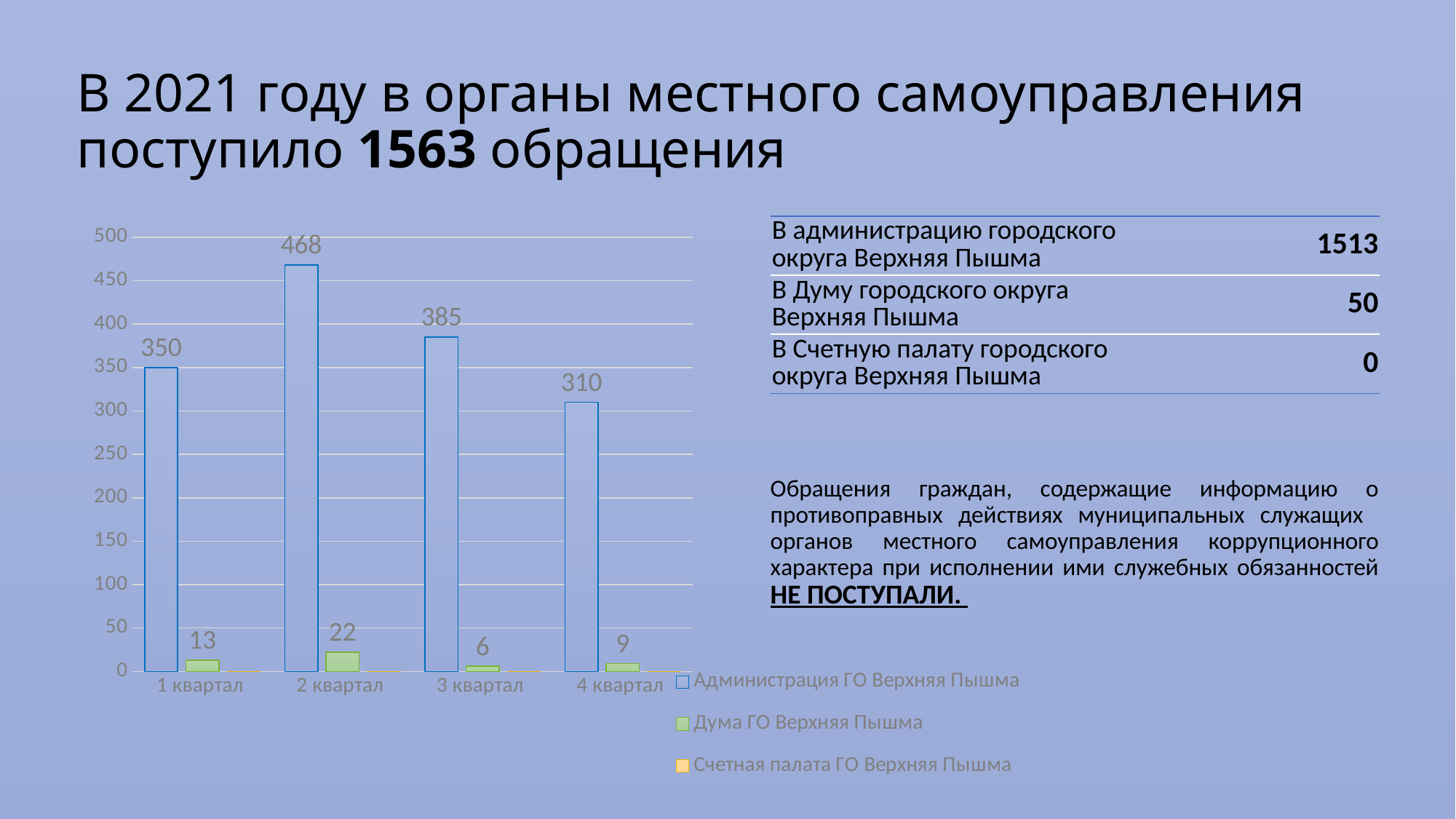
How many quarters are shown on the x axis? 4 What is the value for Дума ГО Верхняя Пышма in 3 квартал? 6 In which quarter is the value for Дума ГО Верхняя Пышма lowest? 3 квартал What is the value for Администрация ГО Верхняя Пышма in 4 квартал? 310 What is the value for Администрация ГО Верхняя Пышма in 2 квартал? 468 Which series is shown in green in the legend? Дума ГО Верхняя Пышма What kind of chart is shown on the slide? bar chart What is the difference between the Администрация ГО Верхняя Пышма values for 2 квартал and 1 квартал? 118 In which quarter is the value for Администрация ГО Верхняя Пышма highest? 2 квартал Which is larger: the Администрация ГО Верхняя Пышма value for 3 квартал or for 4 квартал? 3 квартал Is the value for Администрация ГО Верхняя Пышма in 1 квартал greater or less than 300? greater How many series does the legend list? 3